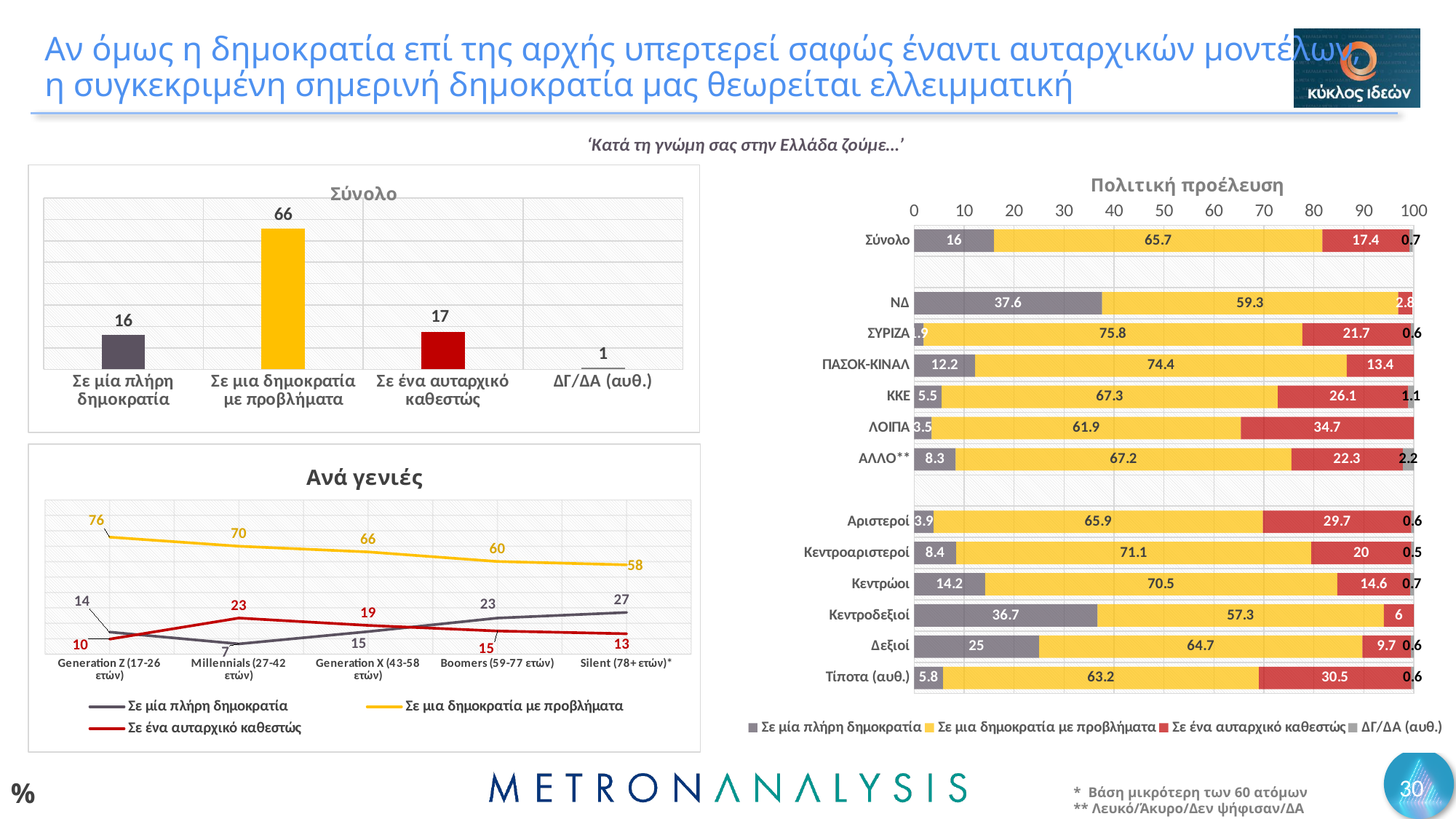
In the 'Ανά γενιές' chart, does the 'Σε μια δημοκρατία με προβλήματα' line rise or fall from Generation Z to Silent? Fall In the 'Πολιτική προέλευση' chart, which group has the highest value for 'Σε ένα αυταρχικό καθεστώς'? ΛΟΙΠΑ What kind of chart is 'Ανά γενιές'? Line chart In the 'Ανά γενιές' chart, how many series does the legend list? 3 In the 'Ανά γενιές' chart, which generation has the highest value for 'Σε ένα αυταρχικό καθεστώς'? Millennials (27-42 ετών) In the 'Ανά γενιές' chart, what is the value of 'Σε μια δημοκρατία με προβλήματα' for Generation Z (17-26 ετών)? 76 In the 'Σύνολο' chart, how many categories are shown? 4 In the 'Πολιτική προέλευση' chart, what is the value of 'Σε μία πλήρη δημοκρατία' for ΝΔ? 37.6 In the 'Σύνολο' chart, what is the difference between 'Σε ένα αυταρχικό καθεστώς' and 'Σε μία πλήρη δημοκρατία'? 1 In the 'Σύνολο' chart, what is the value for 'Σε μια δημοκρατία με προβλήματα'? 66 In the 'Σύνολο' chart, which category has the lowest value? ΔΓ/ΔΑ (αυθ.) In the 'Πολιτική προέλευση' chart, which is larger: 'Σε μια δημοκρατία με προβλήματα' for ΣΥΡΙΖΑ or for ΠΑΣΟΚ-ΚΙΝΑΛ? ΣΥΡΙΖΑ